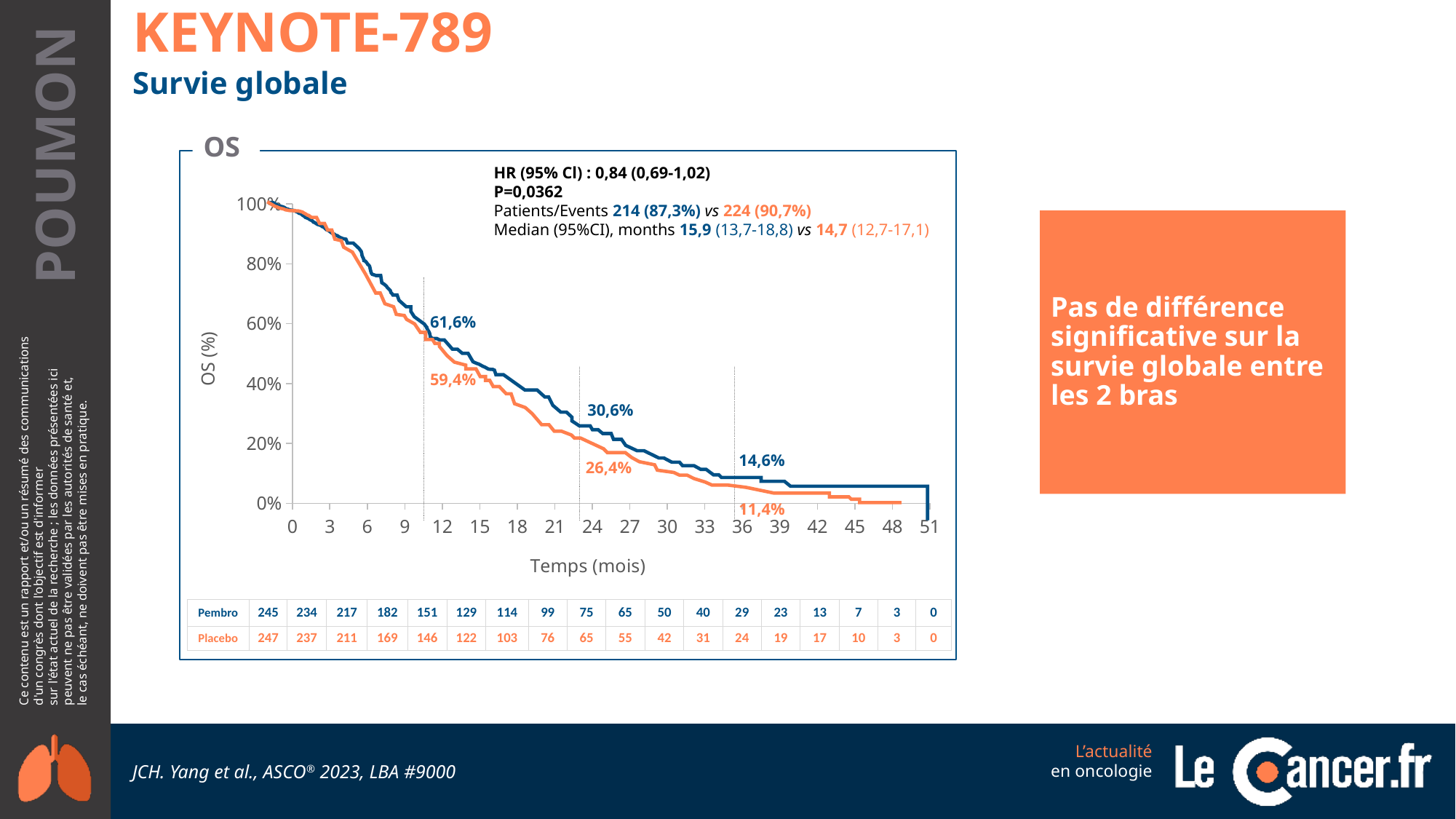
How many patients were at risk in the Pembro arm at 24 months according to the table? 75 What is the OS rate labelled for the Placebo curve at the third dotted line (around 36 months)? 11,4% What is the label of the x axis of the chart? Temps (mois) What is the hazard ratio (HR) shown on the chart? 0,84 (0,69-1,02) What is the OS rate labelled for the Pembro curve at the second dotted line (around 24 months)? 30,6% What is the median OS in months for the Pembro arm according to the text on the chart? 15,9 What is the OS rate labelled for the Placebo (orange) curve at the first dotted line (around 12 months)? 59,4% What is the difference between the Pembro and Placebo OS rates at the third dotted line (14,6% vs 11,4%)? 3,2 percentage points What is the OS rate labelled for the Pembro (blue) curve at the first dotted line (around 12 months)? 61,6% Which arm has the higher labelled OS rate at the second dotted line (around 24 months)? Pembro What type of chart is shown on the slide? Line chart (Kaplan-Meier survival curve) How many patients were at risk in the Placebo arm at time 0 according to the table below the chart? 247